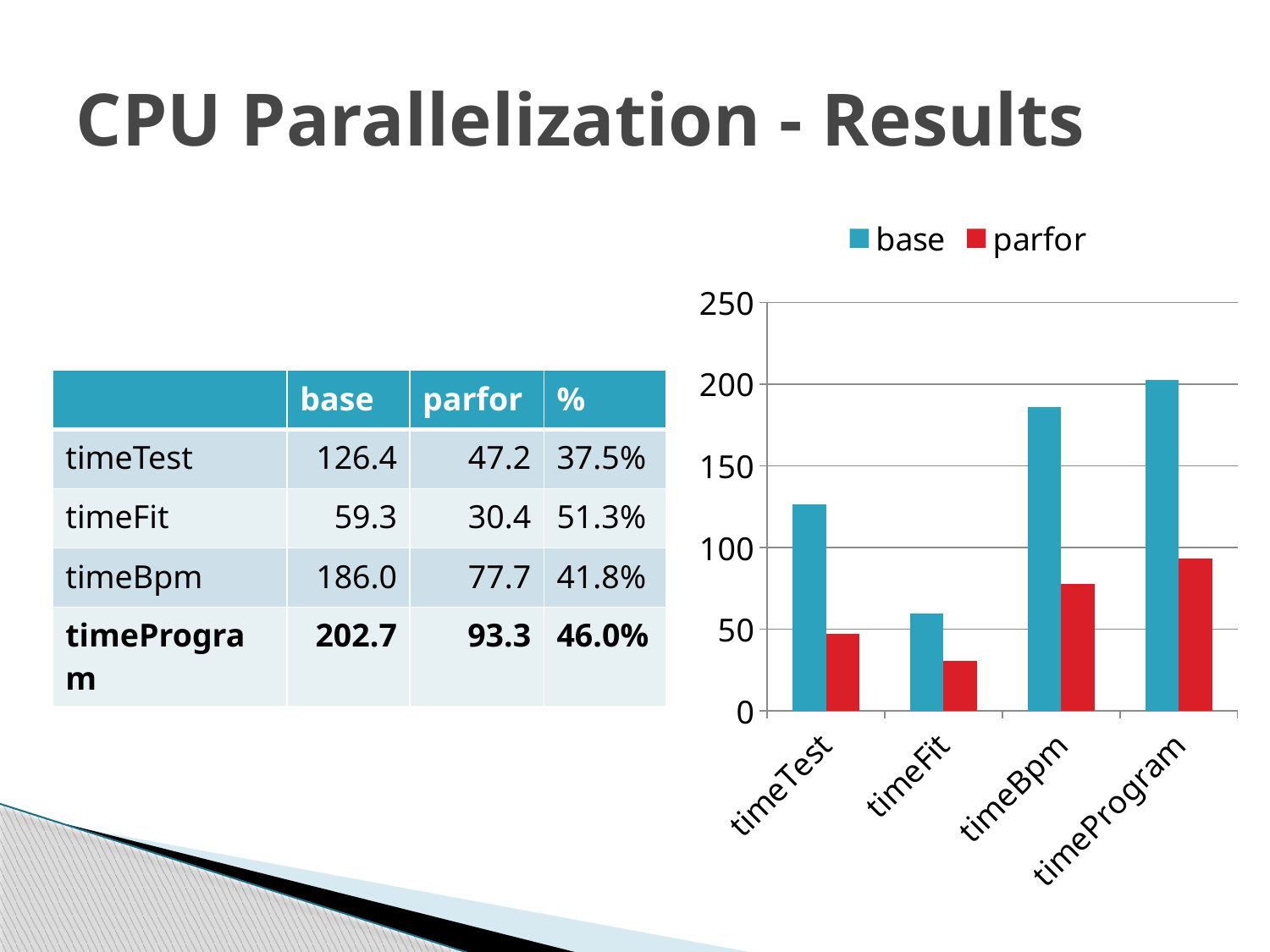
What kind of chart is shown on the slide? bar chart How many series does the chart legend list? 2 Which is larger for timeBpm, the base value or the parfor value? base Is the parfor value for timeFit greater or less than 50? less Is the base value for timeProgram greater or less than 200? greater What colour are the parfor bars in the chart? red How many categories are shown on the x axis of the chart? 4 What is the difference between the base and parfor values for timeProgram? 109.4 Which category has the lowest parfor value in the chart? timeFit What is the parfor value for timeTest? 47.2 What is the base value for timeBpm? 186.0 Which category has the highest base value in the chart? timeProgram